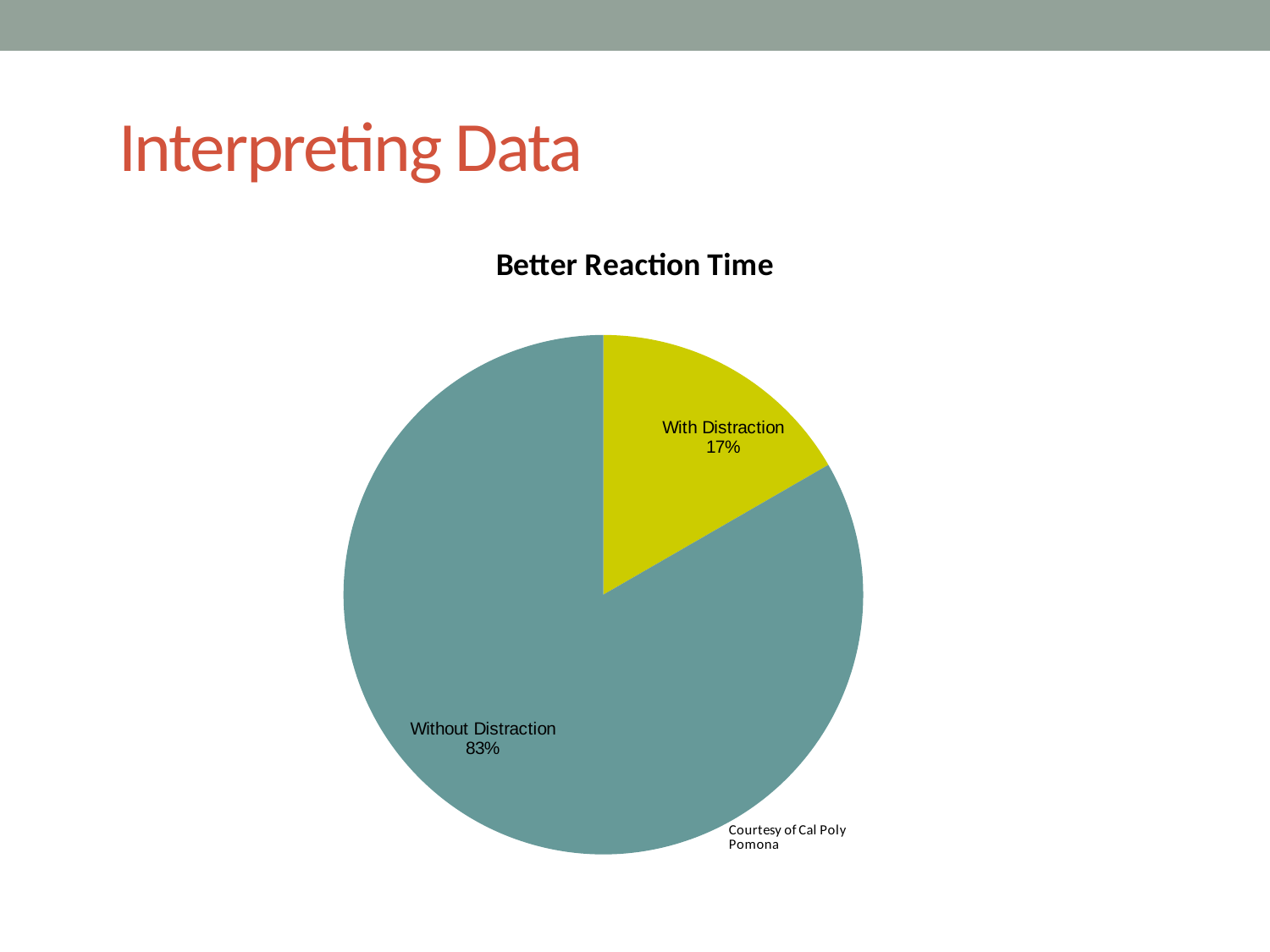
Which slice of the pie is the largest? Without Distraction What percentage is shown for Without Distraction? 83% What share of the pie does the With Distraction slice represent? 17% How many slices does the pie chart have? 2 What colour is the With Distraction slice? yellow-green What is the title of the chart? Better Reaction Time Which is larger, With Distraction or Without Distraction? Without Distraction Which slice of the pie is the smallest? With Distraction What percentage is shown for With Distraction? 17% What is the difference in percentage points between Without Distraction and With Distraction? 66 What type of chart is shown on the slide? pie chart